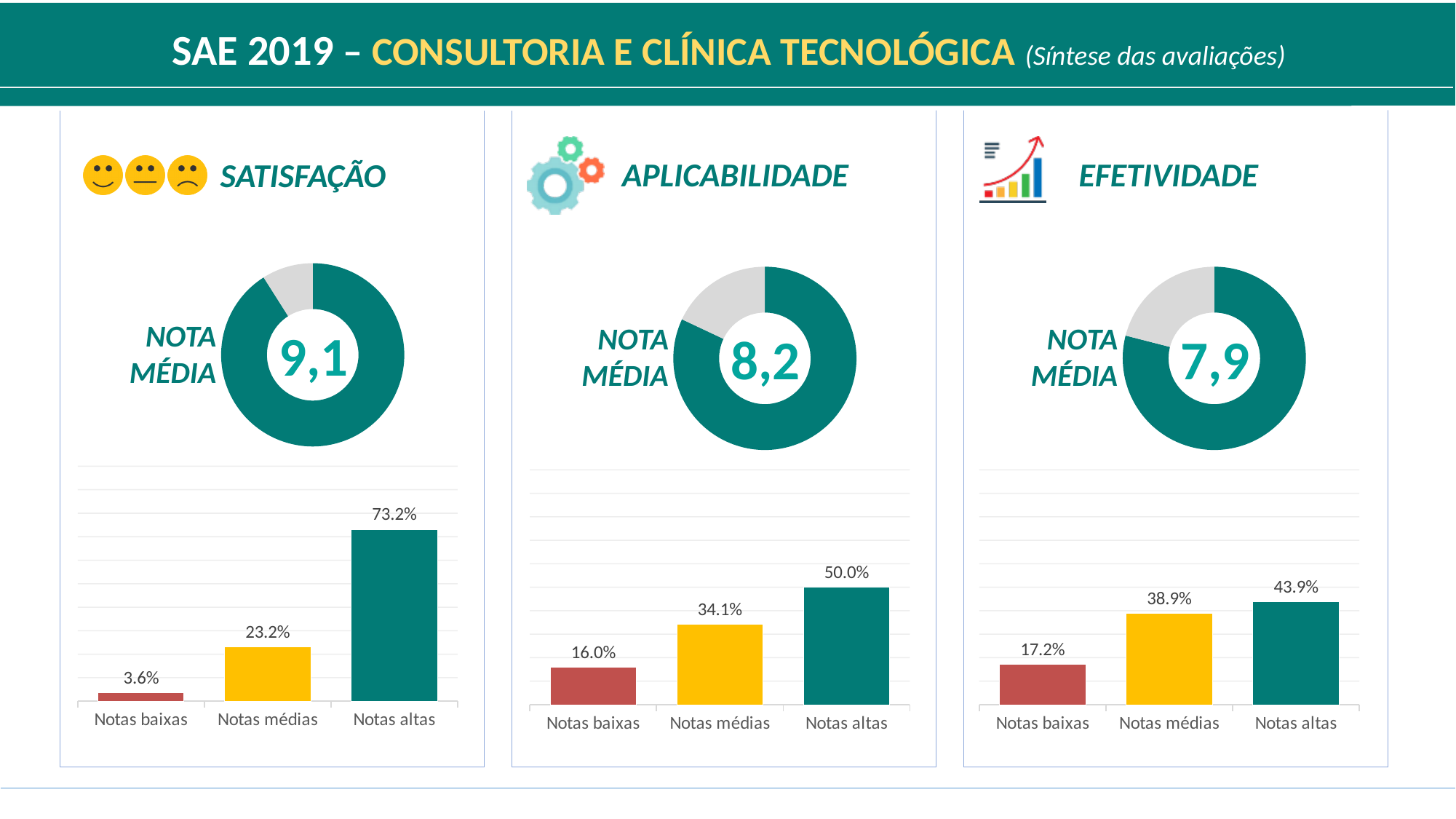
In the APLICABILIDADE bar chart, what is the difference between Notas altas and Notas baixas? 34.0% In the SATISFAÇÃO bar chart, what is the value for Notas altas? 73.2% In the SATISFAÇÃO bar chart, which category has the lowest value? Notas baixas How many categories does the APLICABILIDADE bar chart show? 3 In the EFETIVIDADE bar chart, what is the value for Notas baixas? 17.2% In the APLICABILIDADE bar chart, what is the value for Notas médias? 34.1% What kind of chart is shown below the NOTA MÉDIA donut in the SATISFAÇÃO panel? bar chart In the SATISFAÇÃO bar chart, what is the difference between Notas médias and Notas baixas? 19.6% In the EFETIVIDADE bar chart, do the values rise or fall from Notas baixas to Notas altas? rise What is the NOTA MÉDIA shown in the APLICABILIDADE donut chart? 8,2 In the EFETIVIDADE bar chart, which category has the highest value? Notas altas In the EFETIVIDADE bar chart, which is larger, Notas médias or Notas altas? Notas altas